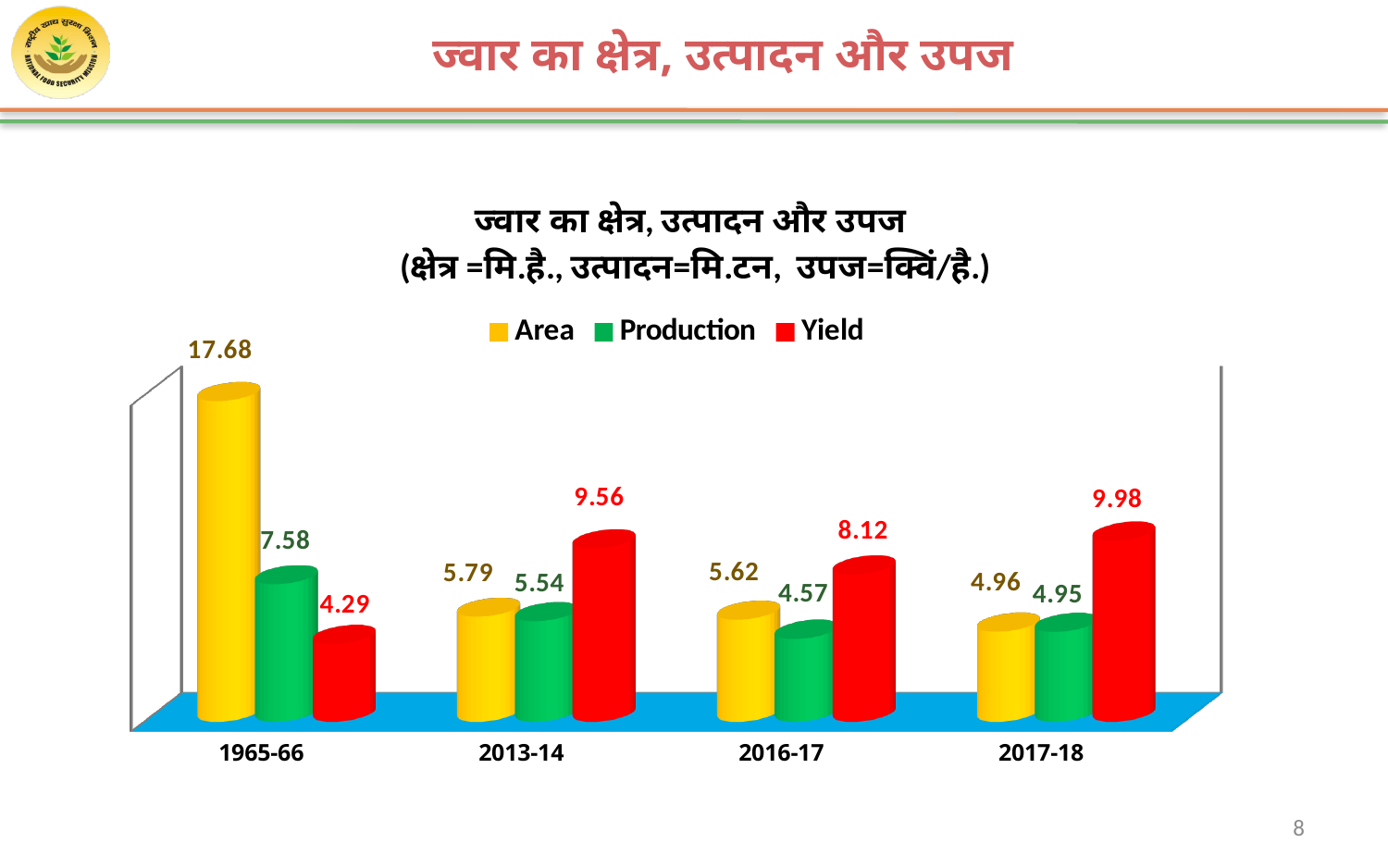
How many year categories are shown on the x axis? 4 What kind of chart is shown on the slide? Bar chart How many series does the legend list? 3 Which year has the highest Yield value? 2017-18 Does the Area value rise or fall from 1965-66 to 2017-18? Fall What is the Production value for 2016-17? 4.57 What is the Yield value for 2017-18? 9.98 What is the difference between the Yield values for 2017-18 and 1965-66? 5.69 Which is larger, the Production value for 2013-14 or for 2017-18? 2013-14 Which year has the lowest Area value? 2017-18 What is the Area value for 1965-66? 17.68 Which colour represents the Yield series in the legend? Red